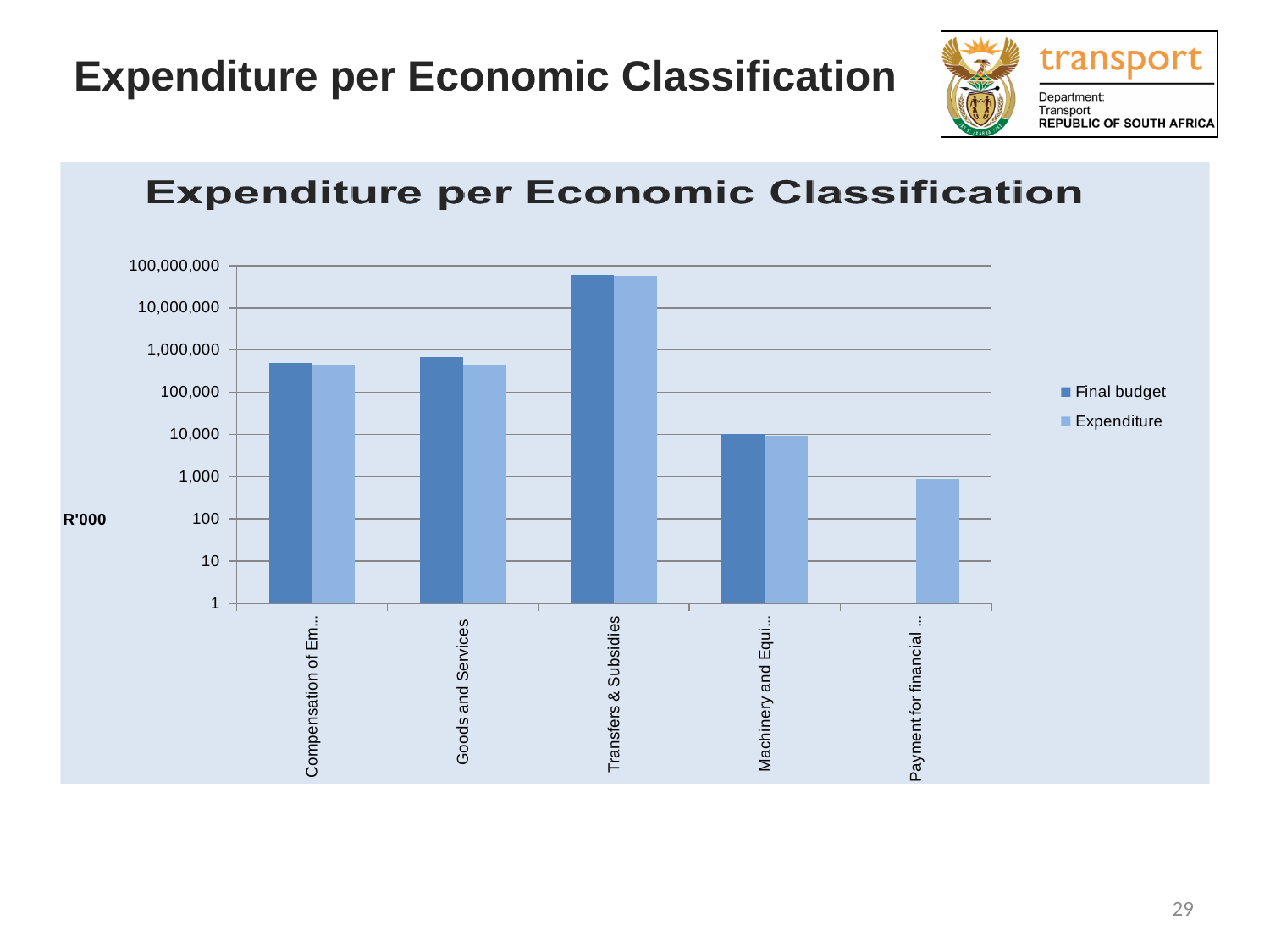
Which category has a larger Final budget, Transfers & Subsidies or Machinery and Equi...? Transfers & Subsidies Is the Expenditure value for Payment for financial ... greater or less than 100? greater What kind of chart is shown on the slide? bar chart Is the Final budget value for Transfers & Subsidies greater or less than 10,000,000? greater Which category has the highest Final budget value? Transfers & Subsidies How many series does the legend list? 2 Which is larger for Goods and Services, the Final budget or the Expenditure? Final budget Is the Final budget value for Goods and Services greater or less than 100,000? greater How many categories are shown on the x axis? 5 Which category has the lowest Expenditure value? Payment for financial ... What unit label is shown next to the y axis? R'000